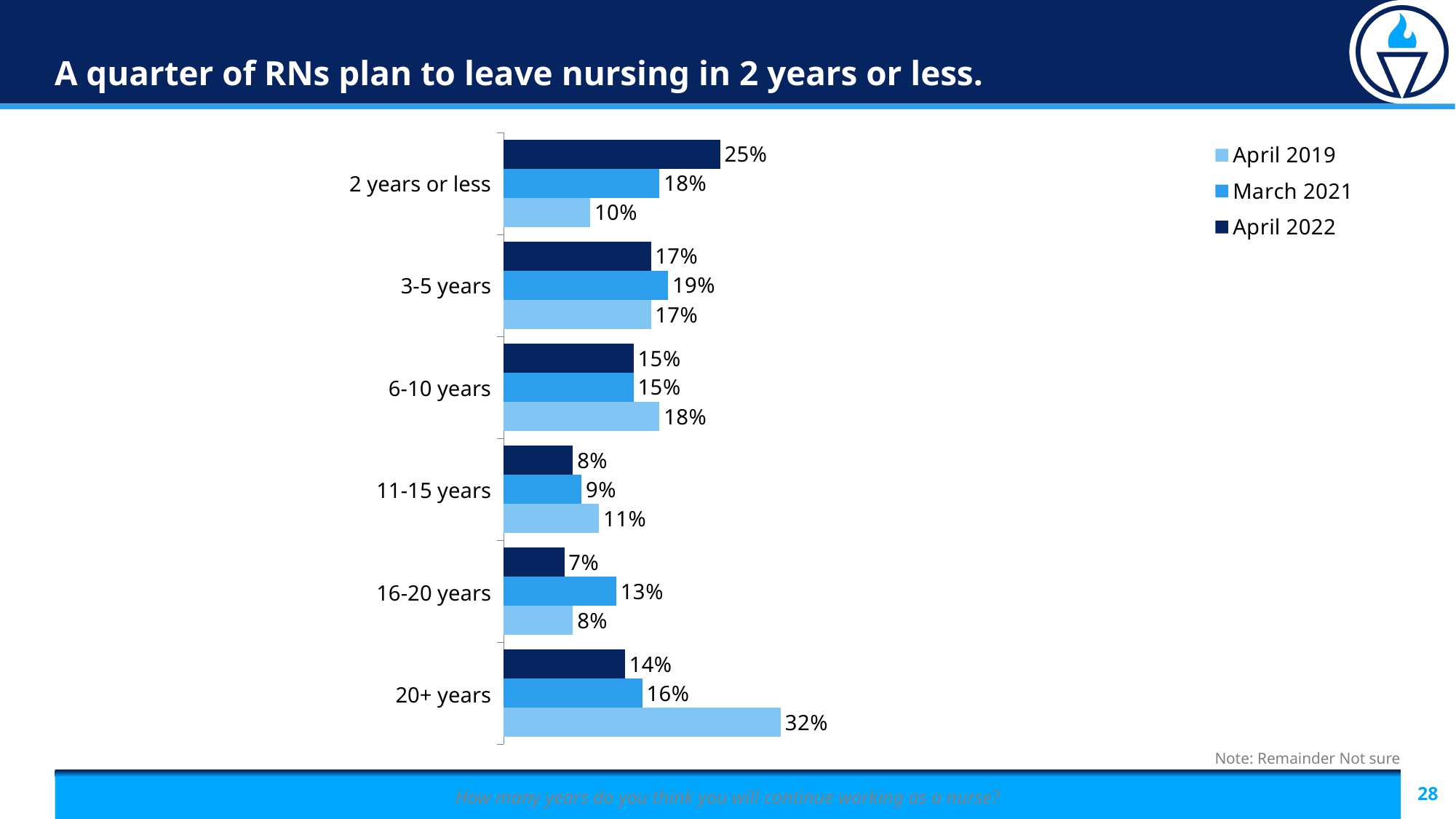
Which category has the highest April 2022 value? 2 years or less What is the March 2021 value for '16-20 years'? 13% What is the April 2019 value for '20+ years'? 32% Which category has the lowest April 2022 value? 16-20 years What kind of chart is shown on the slide? Bar chart How many categories are shown on the chart? 6 Which series is shown in the darkest blue in the legend? April 2022 What is the April 2022 value for '2 years or less'? 25% What is the difference between the April 2022 and April 2019 values for '2 years or less'? 15% What is the difference between the April 2019 and April 2022 values for '20+ years'? 18% Which is larger for '2 years or less': the March 2021 value or the April 2019 value? March 2021 How many series does the legend list? 3